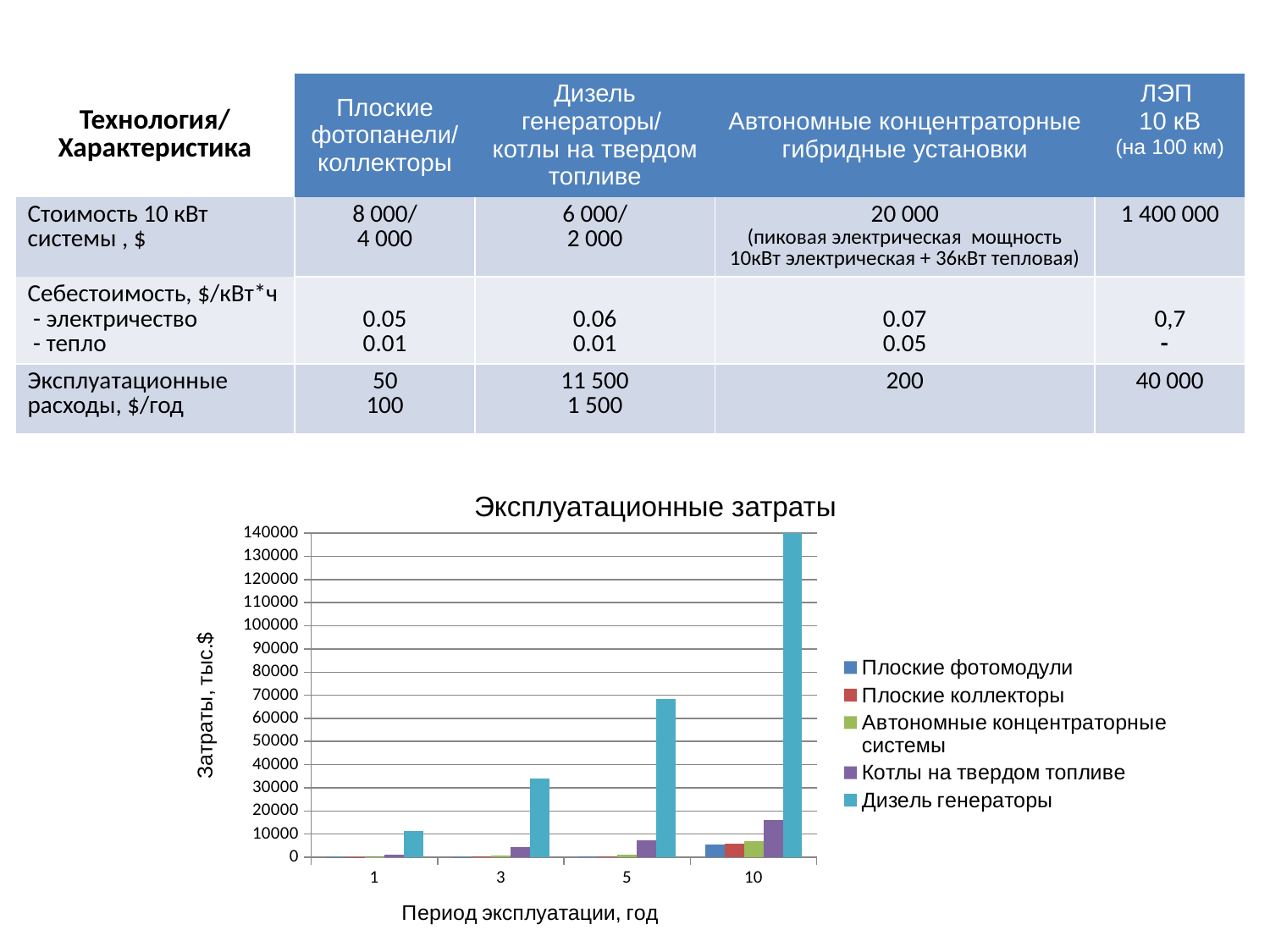
What is the title of the chart? Эксплуатационные затраты How many series does the chart legend list? 5 How many periods (categories) are shown on the x axis of the chart? 4 Do the values for Дизель генераторы rise or fall as the period increases along the x axis? rise What kind of chart is shown on the slide? bar chart Is the value for Котлы на твердом топливе at period 5 greater or less than 10000? less What is the label of the x axis of the chart? Период эксплуатации, год Which series has the highest value at period 10 in the chart? Дизель генераторы At period 10, which is larger: Дизель генераторы or Котлы на твердом топливе? Дизель генераторы Is the value for Котлы на твердом топливе at period 10 greater or less than 20000? less Is the value for Дизель генераторы at period 5 greater or less than 60000? greater